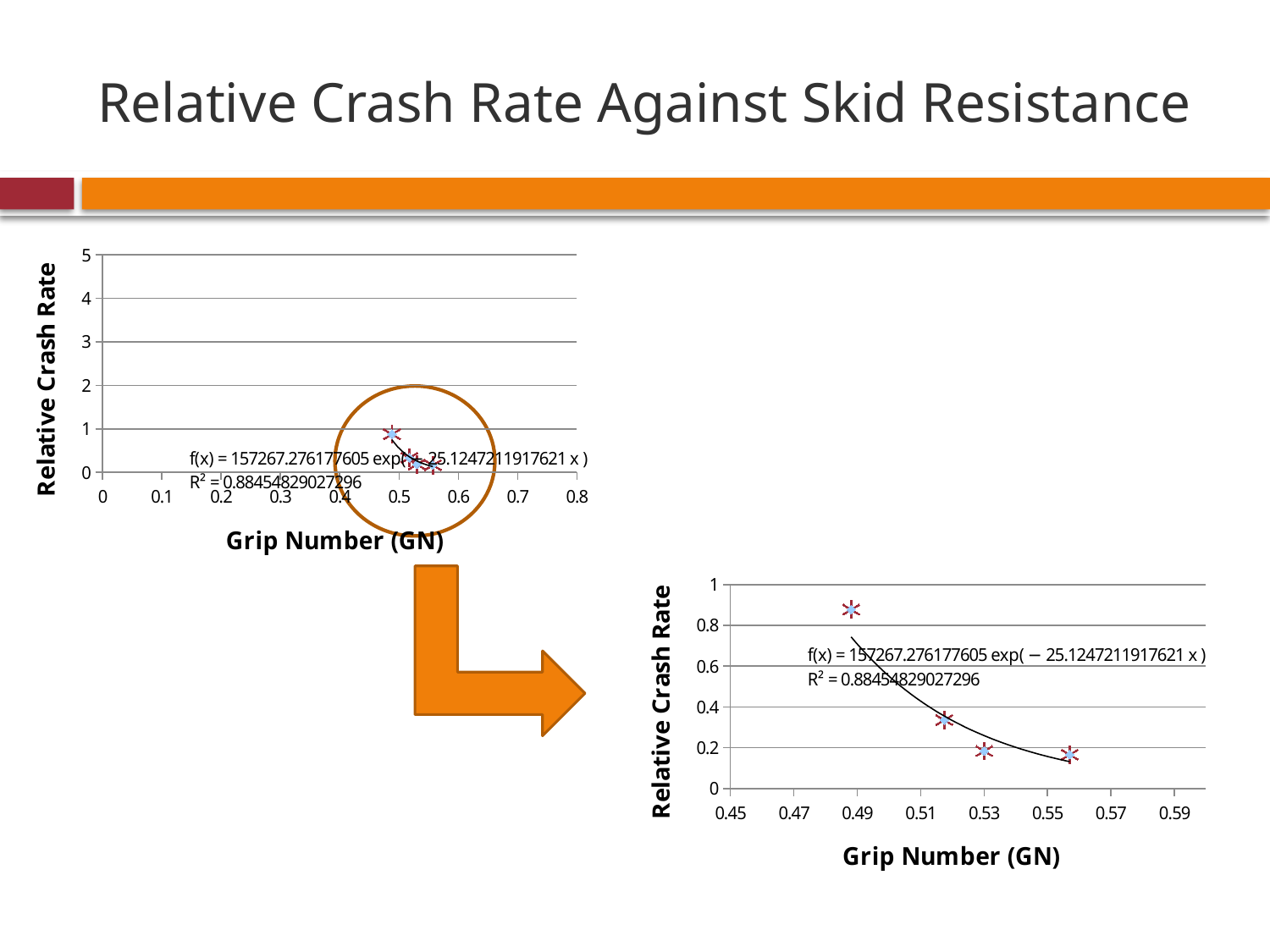
In the bottom-right chart, what is the R² value shown for the fitted trendline? 0.88454829027296 In the bottom-right chart, what is the maximum value shown on the y axis? 1 In the bottom-right chart, is the relative crash rate for the point near a grip number of 0.53 greater or less than 0.4? less In the bottom-right chart, is the relative crash rate for the point near a grip number of 0.49 greater or less than 0.8? greater In the bottom-right chart, is the relative crash rate for the point near a grip number of 0.52 greater or less than 0.6? less In the bottom-right chart, does the relative crash rate rise or fall as the grip number increases? fall What is the title of the x axis of the top-left chart? Grip Number (GN) What kind of chart is the bottom-right chart on the slide? scatter chart In the top-left chart, what is the maximum value shown on the y axis? 5 In the top-left chart, how many data points are plotted? 4 In the bottom-right chart, which point has the highest relative crash rate: the one near a grip number of 0.49 or the one near 0.53? the one near 0.49 In the bottom-right chart, how many data points are plotted? 4